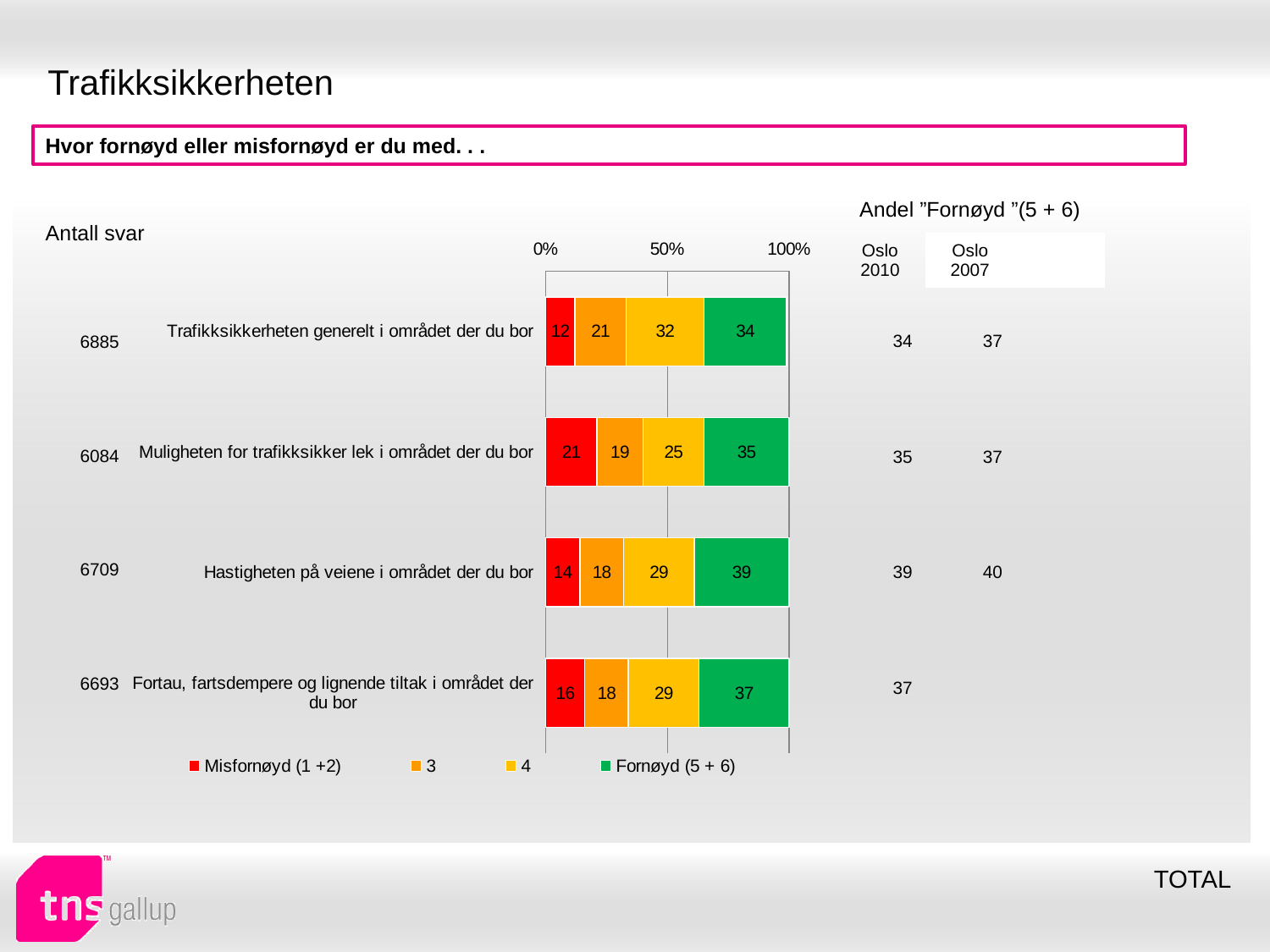
What is the difference between the Fornøyd (5 + 6) values for "Hastigheten på veiene i området der du bor" and "Trafikksikkerheten generelt i området der du bor"? 5 What is the total of the stacked bar for "Fortau, fartsdempere og lignende tiltak i området der du bor"? 100 What is the value of the "4" segment for "Trafikksikkerheten generelt i området der du bor"? 32 Which is larger: the "3" segment for "Trafikksikkerheten generelt i området der du bor" or the "3" segment for "Muligheten for trafikksikker lek i området der du bor"? Trafikksikkerheten generelt i området der du bor Which category has the lowest Misfornøyd (1 +2) value? Trafikksikkerheten generelt i området der du bor What kind of chart is shown on the slide? Stacked bar chart How many categories are shown in the bar chart? 4 Which colour represents the Fornøyd (5 + 6) series in the legend? Green What is the value of the Misfornøyd (1 +2) segment for "Muligheten for trafikksikker lek i området der du bor"? 21 What is the value of the Fornøyd (5 + 6) segment for "Hastigheten på veiene i området der du bor"? 39 Which category has the highest Fornøyd (5 + 6) value? Hastigheten på veiene i området der du bor How many series does the legend list? 4